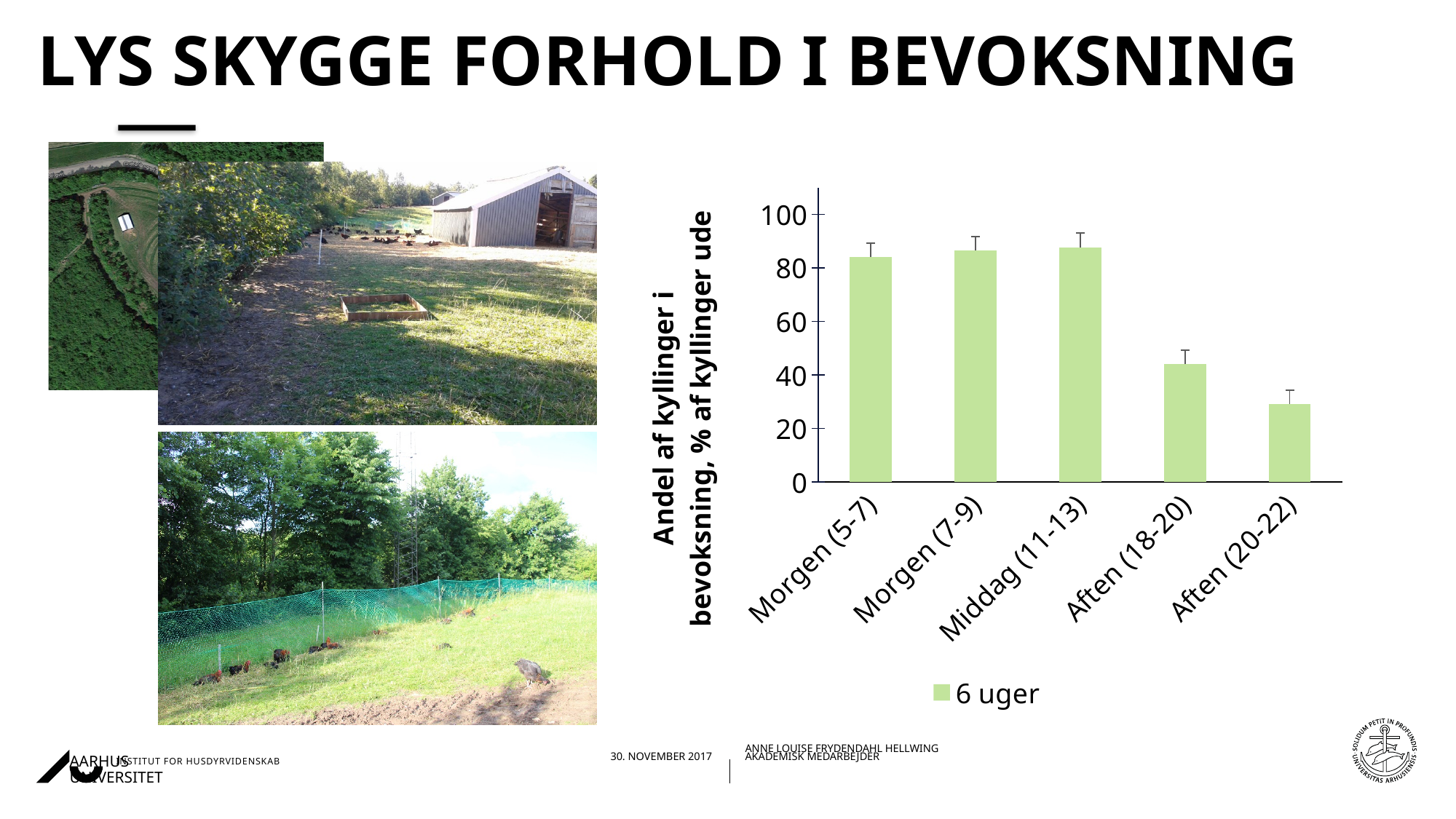
Which is larger, the value for Aften (18-20) or the value for Aften (20-22)? Aften (18-20) Is the value for Aften (18-20) greater or less than 40? greater How many series does the chart legend list? 1 What is the y-axis label of the chart? Andel af kyllinger i bevoksning, % af kyllinger ude Do the values fall or rise from Middag (11-13) to Aften (20-22)? fall What kind of chart is shown on the slide? bar chart Is the value for Aften (20-22) greater or less than 40? less Is the value for Morgen (5-7) greater or less than 80? greater Which is larger, the value for Morgen (5-7) or the value for Aften (18-20)? Morgen (5-7) What is the name of the series shown in the chart legend? 6 uger Which category has the lowest value in the chart? Aften (20-22) How many categories are shown on the x axis of the chart? 5